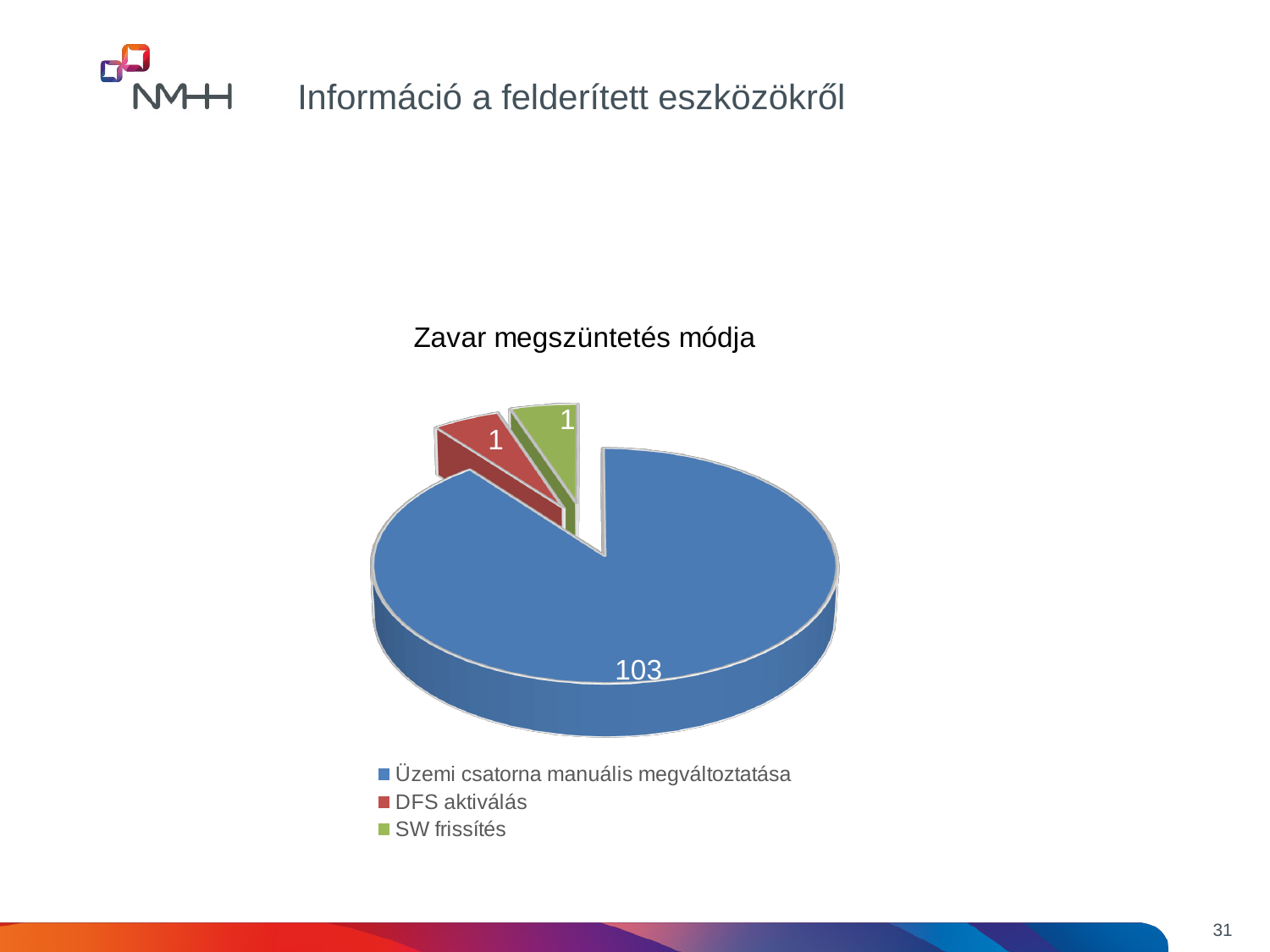
How many entries does the legend list? 3 What is the title of the chart? Zavar megszüntetés módja What is the total of all slices in the pie chart? 105 What is the value for Üzemi csatorna manuális megváltoztatása? 103 Which category has the largest slice? Üzemi csatorna manuális megváltoztatása Which is larger, the value for Üzemi csatorna manuális megváltoztatása or the value for SW frissítés? Üzemi csatorna manuális megváltoztatása How many slices does the pie chart have? 3 What is the difference between the values for Üzemi csatorna manuális megváltoztatása and DFS aktiválás? 102 What is the value for SW frissítés? 1 Which colour represents DFS aktiválás in the chart? red What is the value for DFS aktiválás? 1 What kind of chart is shown on the slide? pie chart